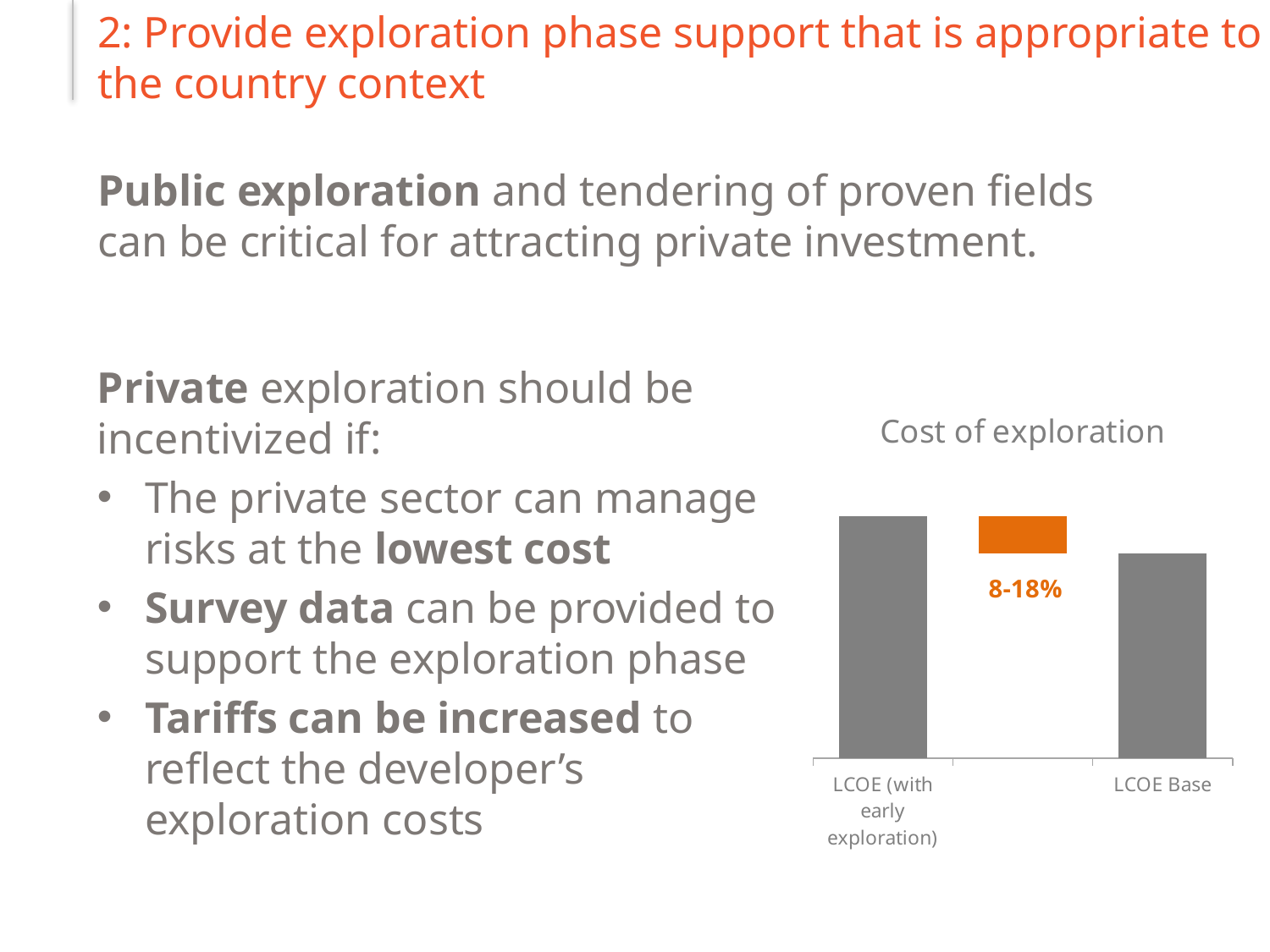
In the "Cost of exploration" chart, is the bar for LCOE (with early exploration) taller or shorter than the bar for LCOE Base? taller In the "Cost of exploration" chart, what colour is the segment labeled 8-18%? orange What is the title of the chart on the slide? Cost of exploration What type of chart is shown under the title "Cost of exploration"? bar chart In the "Cost of exploration" chart, which labeled category has the shorter bar? LCOE Base How many labeled categories appear on the x axis of the "Cost of exploration" chart? 2 In the "Cost of exploration" chart, what percentage range is printed next to the orange segment between the two gray bars? 8-18% In the "Cost of exploration" chart, which labeled category has the taller bar? LCOE (with early exploration) In the "Cost of exploration" chart, do the gray bars rise or fall from left to right? fall